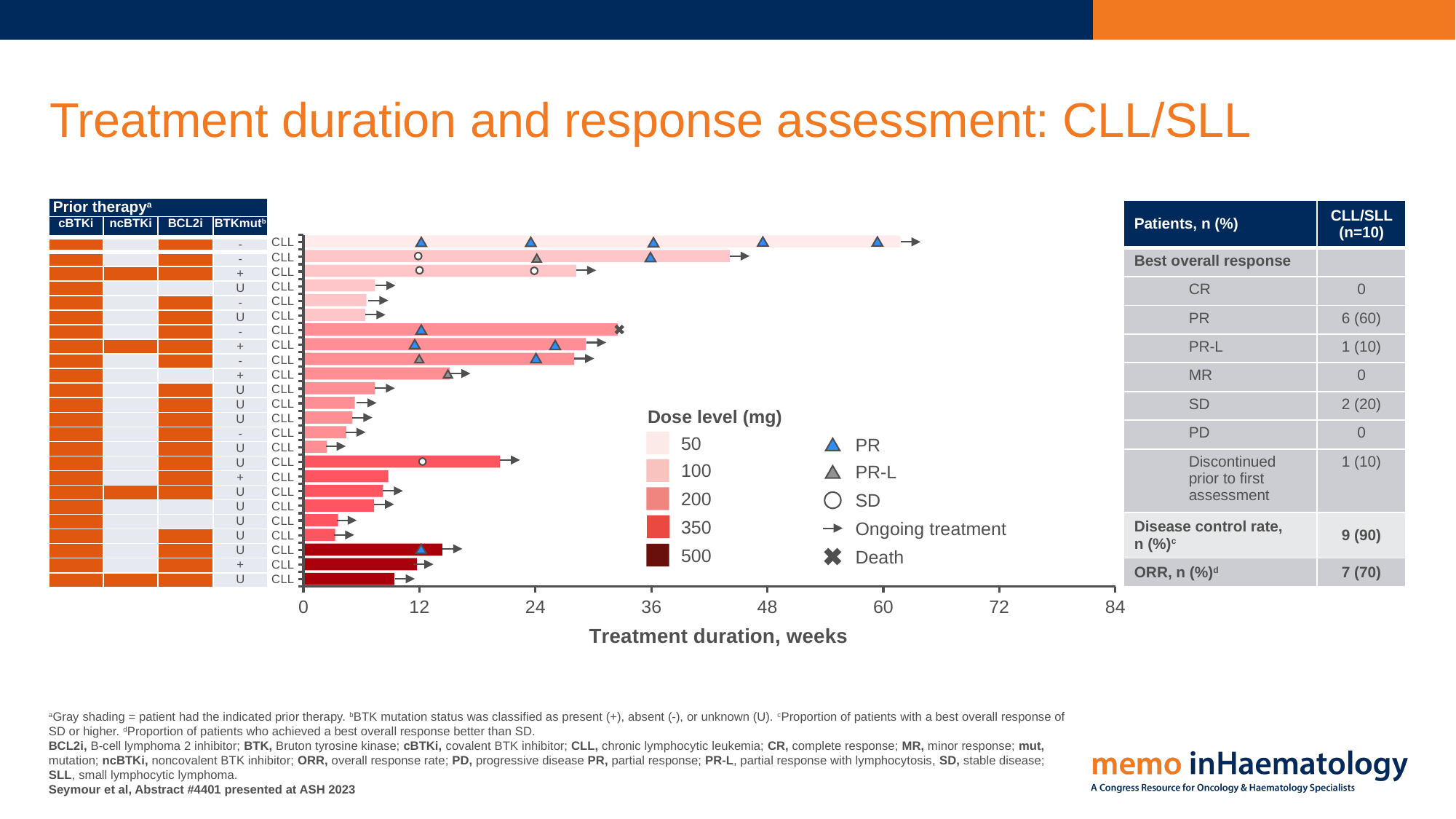
Is the treatment duration of the longest bar in the chart greater or less than 60 weeks? greater What is the title of the x axis of the chart? Treatment duration, weeks How many patient bars are plotted in the chart? 24 What is the maximum value shown on the x axis of the chart? 84 How many dose levels are listed in the chart's 'Dose level (mg)' legend? 5 What is the lowest dose level listed in the chart legend? 50 What is the highest dose level listed in the chart legend? 500 How many bars in the chart are at the 500 mg dose level? 3 Is the treatment duration of the bar marked with the Death symbol greater or less than 24 weeks? greater Which symbol in the chart legend represents Death? A cross (X) What kind of chart is shown on the slide? Bar chart Which dose level (mg) does the longest bar in the chart belong to? 50